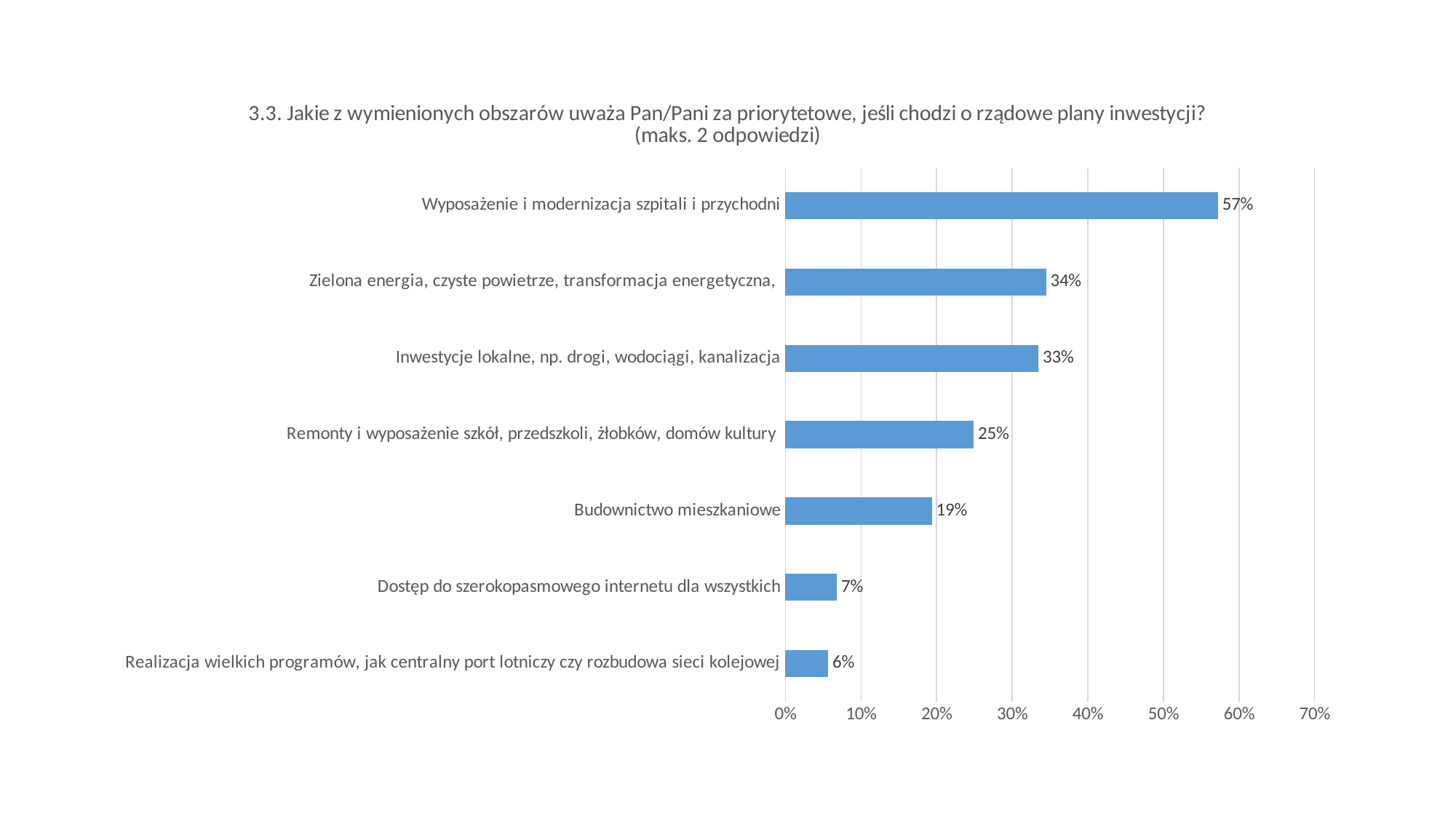
What is the difference in percentage points between "Wyposażenie i modernizacja szpitali i przychodni" and "Zielona energia, czyste powietrze, transformacja energetyczna"? 23 percentage points What is the difference in percentage points between "Remonty i wyposażenie szkół, przedszkoli, żłobków, domów kultury" and "Budownictwo mieszkaniowe"? 6 percentage points What is the maximum value shown on the horizontal axis of the chart? 70% What is the value shown for "Budownictwo mieszkaniowe"? 19% What type of chart is shown on the slide? Bar chart Which has a larger value: "Inwestycje lokalne, np. drogi, wodociągi, kanalizacja" or "Remonty i wyposażenie szkół, przedszkoli, żłobków, domów kultury"? Inwestycje lokalne, np. drogi, wodociągi, kanalizacja Which category has the highest value on the chart? Wyposażenie i modernizacja szpitali i przychodni What percentage of respondents chose "Wyposażenie i modernizacja szpitali i przychodni" as a priority? 57% How many categories are shown on the chart? 7 Which category has the lowest value on the chart? Realizacja wielkich programów, jak centralny port lotniczy czy rozbudowa sieci kolejowej Is the value for "Zielona energia, czyste powietrze, transformacja energetyczna" greater or less than 30%? greater What is the value shown for "Dostęp do szerokopasmowego internetu dla wszystkich"? 7%